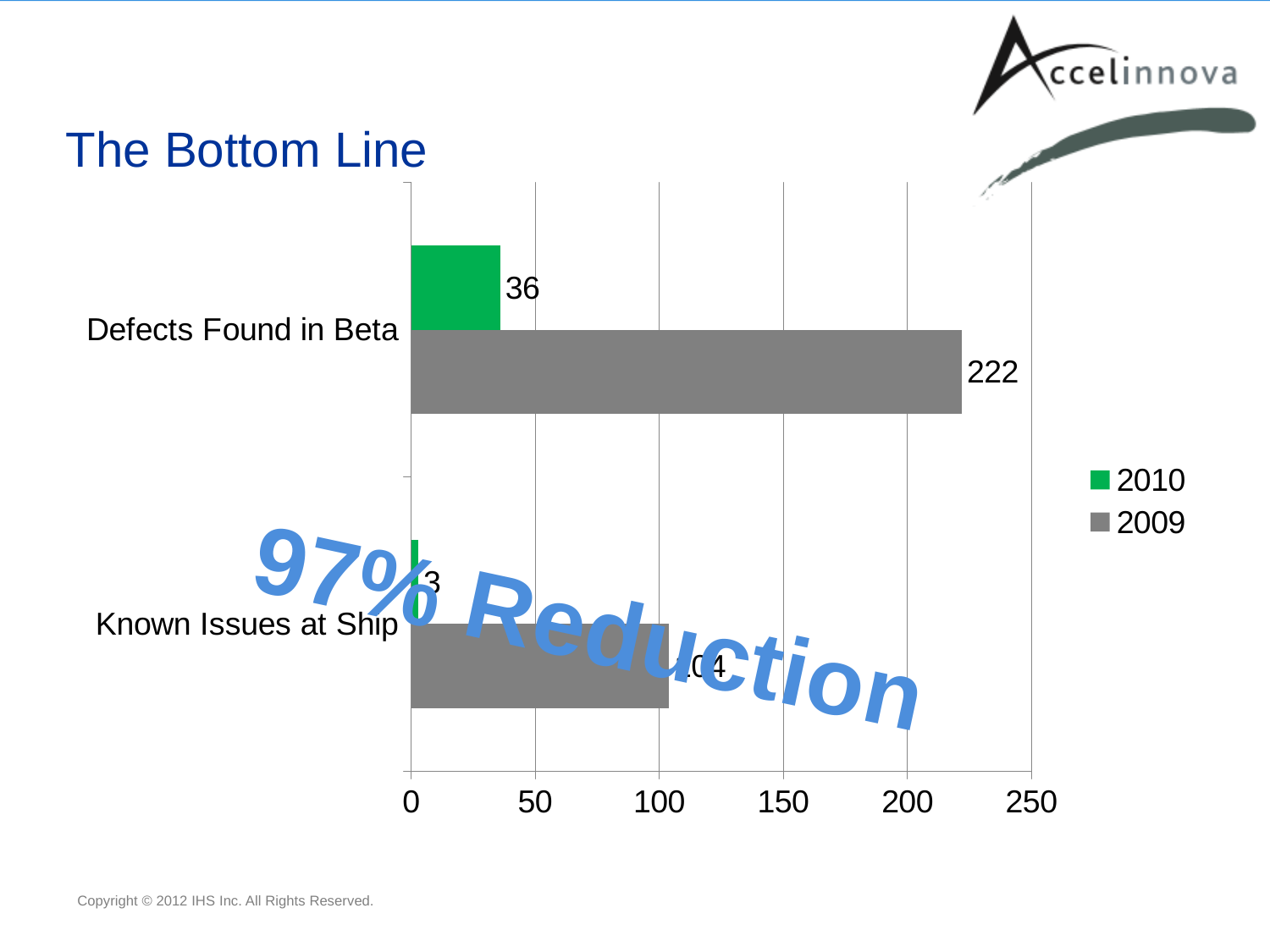
For Defects Found in Beta, which series has the larger value, 2009 or 2010? 2009 Which category has the highest 2009 value? Defects Found in Beta What is the 2009 value for Defects Found in Beta? 222 What is the difference between the 2010 values for Defects Found in Beta and Known Issues at Ship? 33 What is the 2010 value for Known Issues at Ship? 3 What kind of chart is shown on the slide? bar chart What colour represents the 2010 series in the chart? green How many series does the legend list? 2 What is the difference between the 2009 and 2010 values for Defects Found in Beta? 186 What is the 2010 value for Defects Found in Beta? 36 How many categories are shown on the chart? 2 Is the 2009 value for Known Issues at Ship greater or less than 150? less